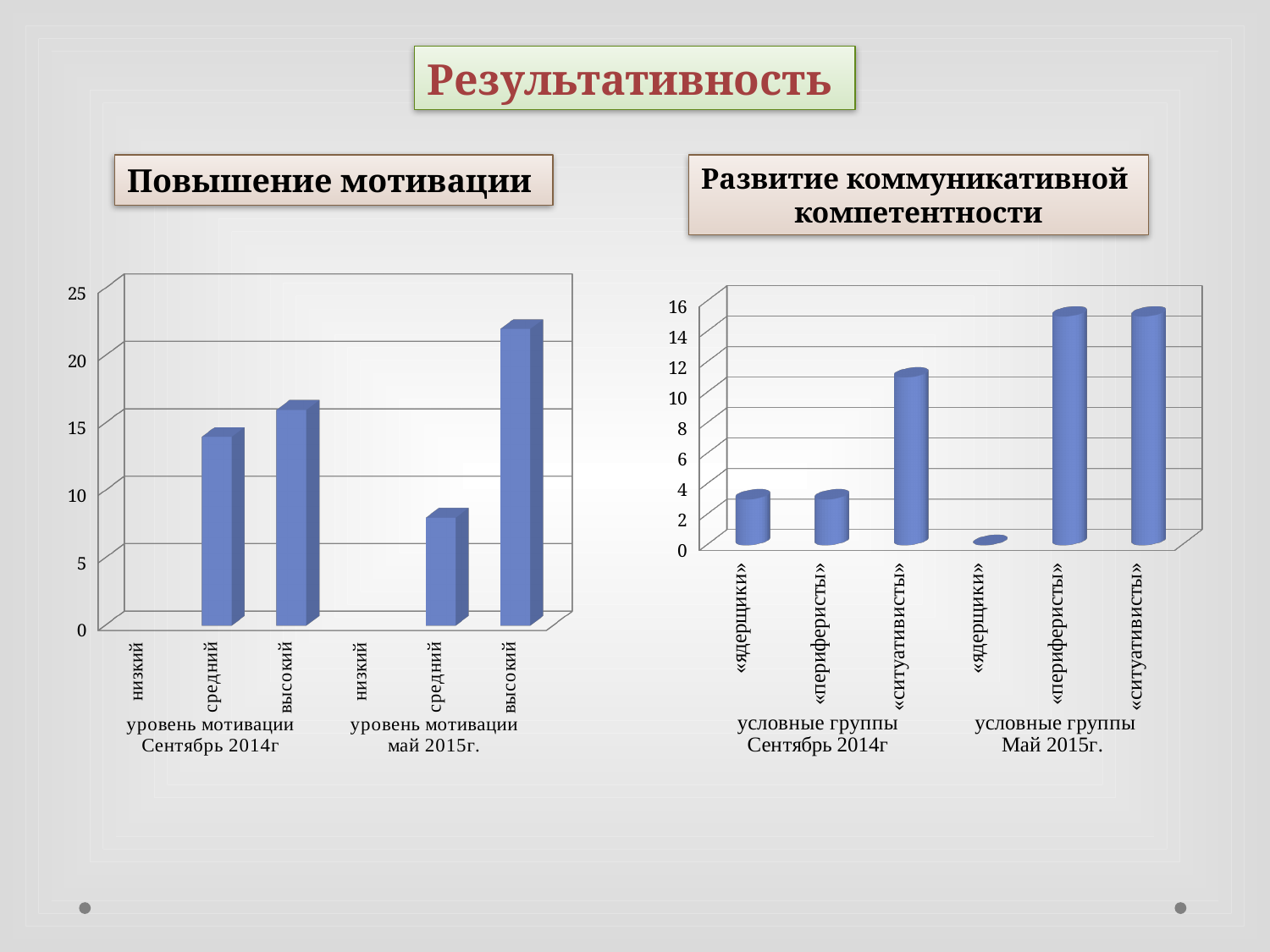
What kind of chart is the left chart, "Повышение мотивации"? bar chart In the left chart "Повышение мотивации", is the value for "высокий" in май 2015г. greater or less than 20? greater In the left chart "Повышение мотивации", how many categories are shown on the x axis? 6 In the right chart "Развитие коммуникативной компетентности", which is larger: "периферисты" in Сентябрь 2014г or "периферисты" in Май 2015г.? периферисты in Май 2015г. In the left chart "Повышение мотивации", which category has the highest bar? высокий (уровень мотивации май 2015г.) In the left chart "Повышение мотивации", is the value for "средний" in май 2015г. greater or less than 10? less In the right chart "Развитие коммуникативной компетентности", how many categories are shown on the x axis? 6 What is the title of the slide? Результативность In the right chart "Развитие коммуникативной компетентности", is the value for "ситуативисты" in Сентябрь 2014г greater or less than 10? greater What kind of chart is the right chart, "Развитие коммуникативной компетентности"? bar chart In the left chart "Повышение мотивации", which is larger: "средний" in Сентябрь 2014г or "средний" in май 2015г.? средний in Сентябрь 2014г